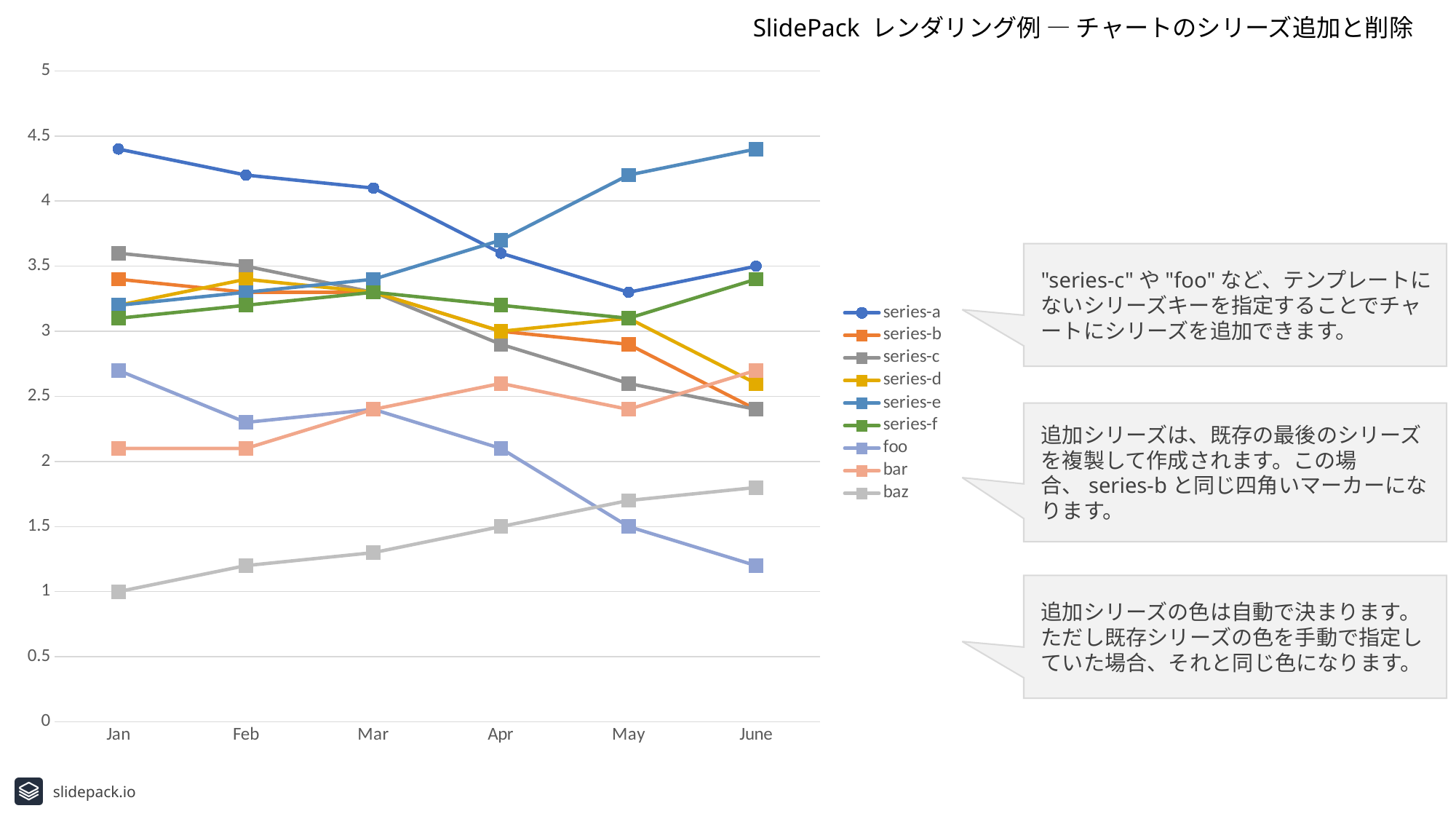
How many categories are on the x axis? 6 Is the value for series-a in Jan greater or less than 4? greater What kind of chart is shown on the slide? line chart Do the values for baz rise or fall from Jan to June? rise Which is larger in June, series-a or series-e? series-e Which series has the lowest value in June? foo How many series does the legend list? 9 Which series has the highest value in Jan? series-a Do the values for foo rise or fall from Jan to June? fall Is the value for bar in Jan greater or less than 2.5? less Which series has the highest value in June? series-e Is the value for baz in June greater or less than 2? less